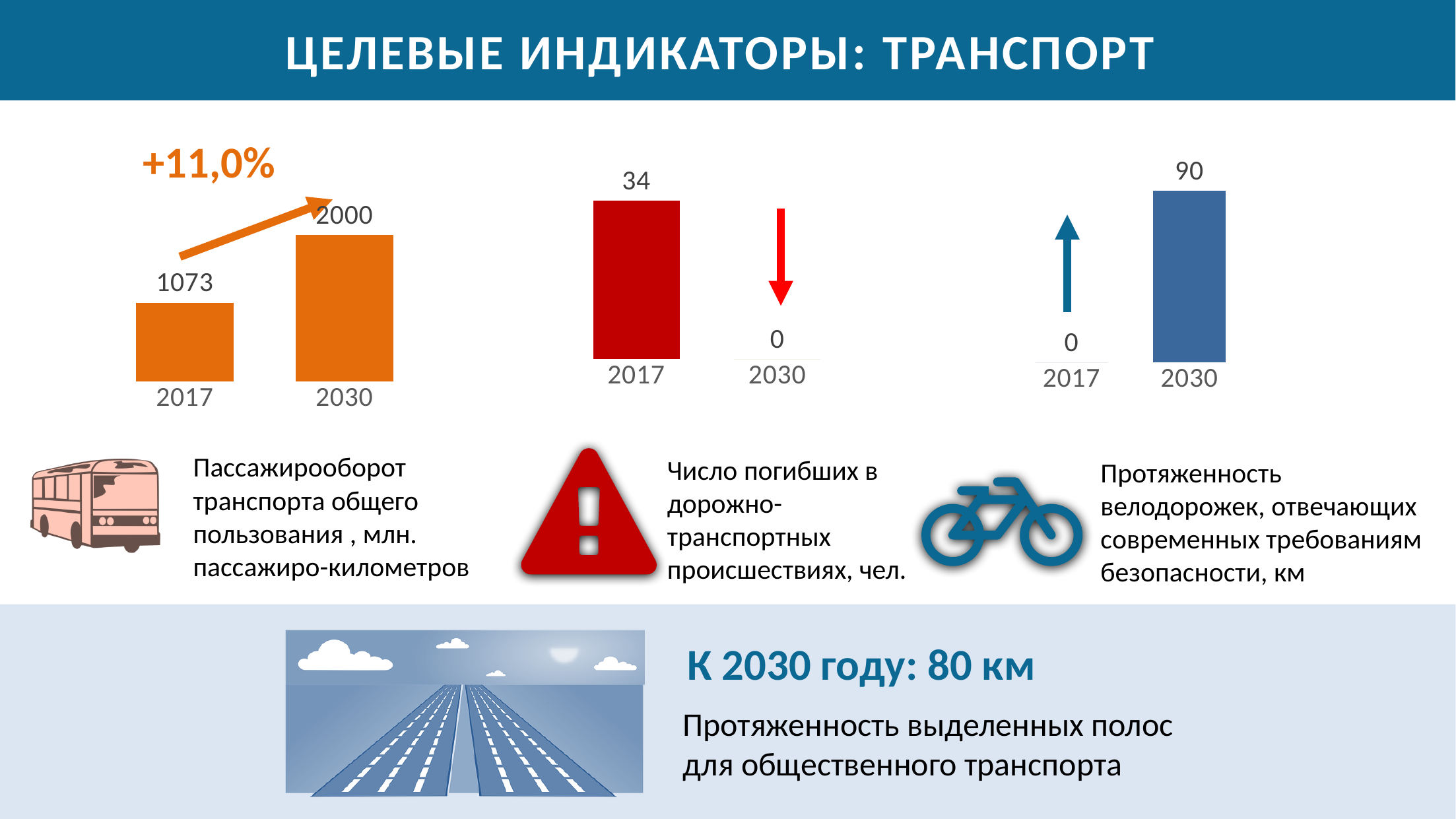
In the middle chart (number of road traffic deaths), what is the value for 2030? 0 In the right chart (length of bicycle lanes), which year has the higher value? 2030 In the middle chart (number of road traffic deaths), what is the value for 2017? 34 In the right chart (length of bicycle lanes), what is the value for 2030? 90 What kind of chart is the left chart (passenger turnover of public transport)? bar chart How many categories (years) does the middle chart (number of road traffic deaths) show? 2 In the left chart (passenger turnover of public transport), which year has the lower value? 2017 In the left chart (passenger turnover of public transport), what is the value for 2030? 2000 In the middle chart (number of road traffic deaths), do the values rise or fall from 2017 to 2030? fall In the right chart (length of bicycle lanes), what is the value for 2017? 0 In the left chart (passenger turnover of public transport), what is the value for 2017? 1073 In the left chart (passenger turnover of public transport), what is the difference between the 2030 and 2017 values? 927